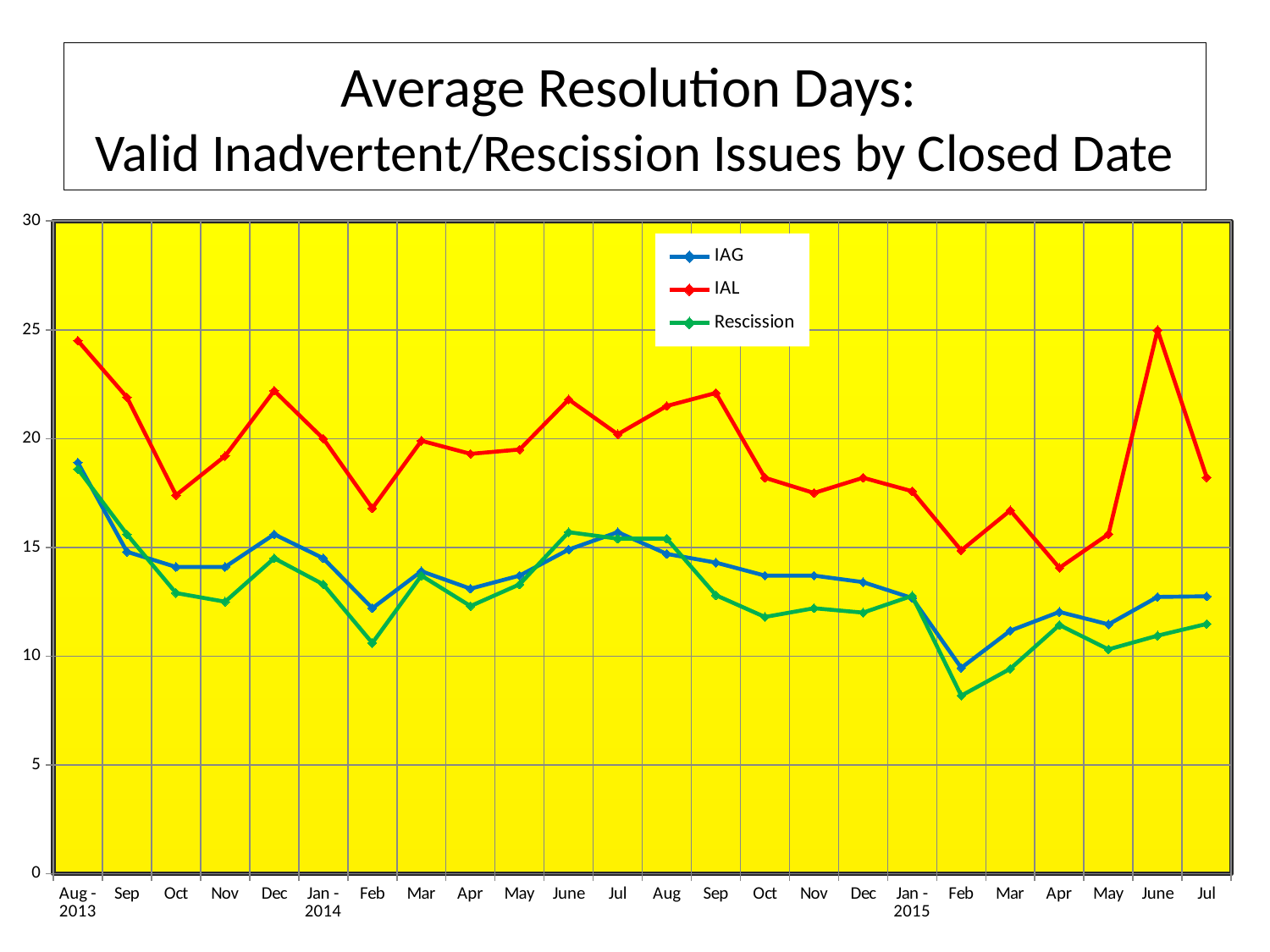
What is the title of the chart? Average Resolution Days: Valid Inadvertent/Rescission Issues by Closed Date Which series is drawn in red? IAL Is the IAL value for June 2015 greater or less than 20? greater How many months (data points) are plotted along the x axis? 24 Is the IAL value for Aug 2013 greater or less than 20? greater Is the Rescission value for Feb 2015 greater or less than 10? less What kind of chart is shown on the slide? line chart Does the IAL series rise or fall from Apr 2015 to June 2015? rise In which month is the Rescission series at its lowest? Feb 2015 Which series has the larger value in Aug 2013, IAL or IAG? IAL How many series does the legend list? 3